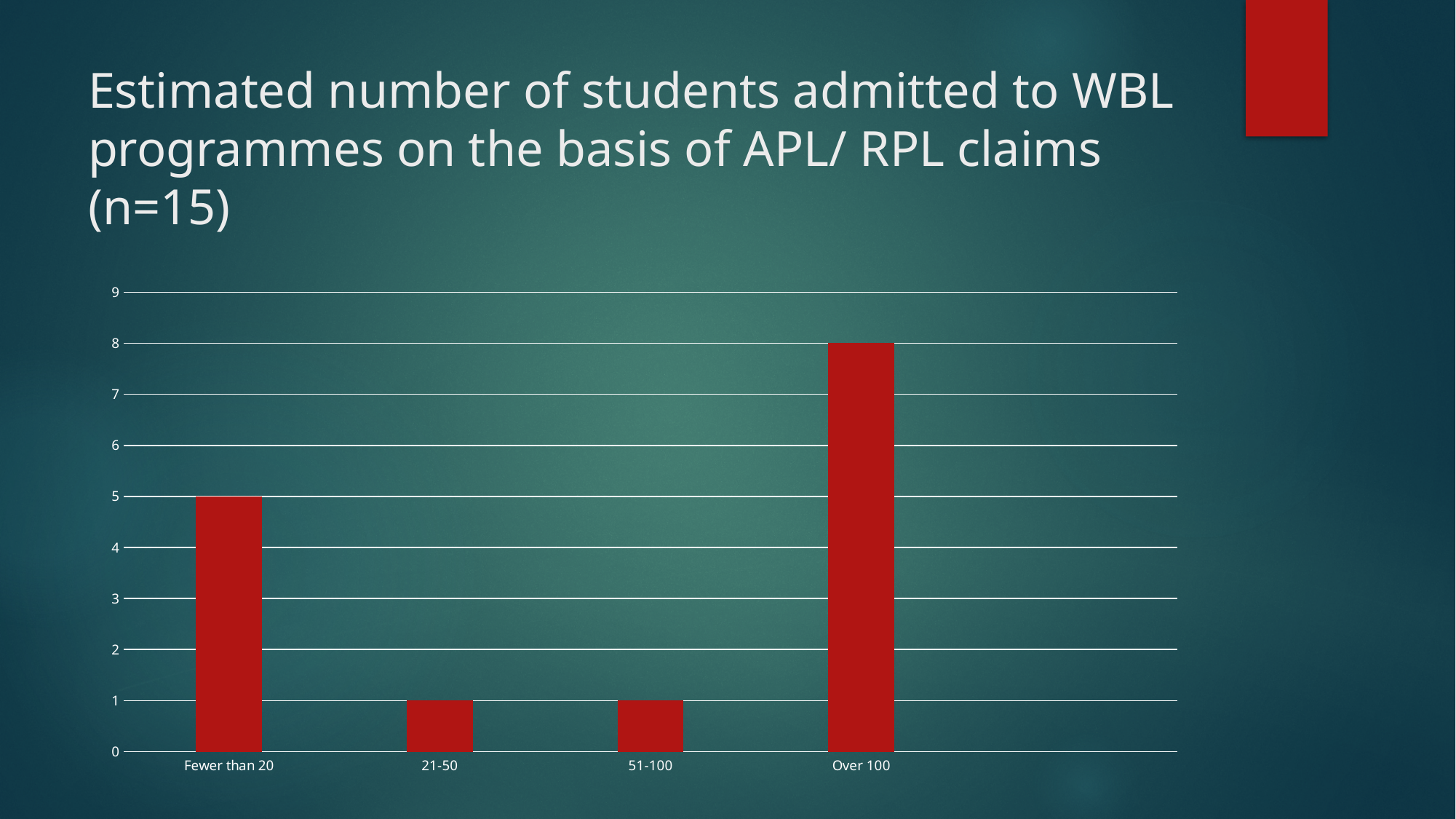
What type of chart is shown on the slide? bar chart Which is larger, the value for 'Fewer than 20' or the value for '51-100'? Fewer than 20 What is the title of the chart on the slide? Estimated number of students admitted to WBL programmes on the basis of APL/ RPL claims (n=15) What is the highest value shown on the vertical axis? 9 Which category has the highest value? Over 100 What is the value for the '21-50' category? 1 How many categories are shown on the x axis of the chart? 4 What is the value for the 'Over 100' category? 8 Is the value for 'Over 100' greater or less than 6? greater What is the difference between the values for 'Over 100' and 'Fewer than 20'? 3 What is the value for the '51-100' category? 1 What is the value for the 'Fewer than 20' category? 5